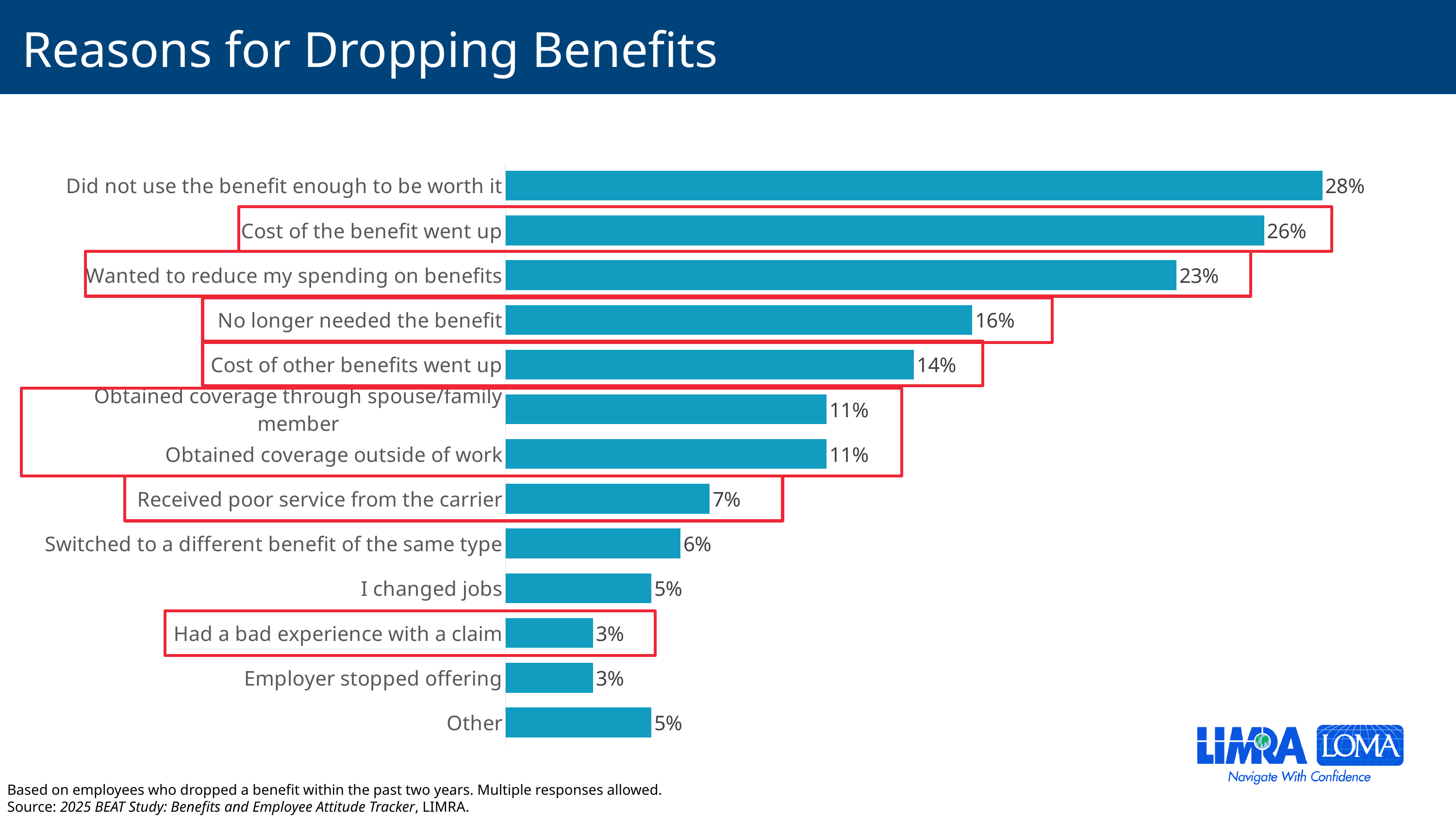
What type of chart is shown on the slide? Bar chart What percentage of employees cited "Did not use the benefit enough to be worth it" as a reason for dropping benefits? 28% What is the title of the chart on the slide? Reasons for Dropping Benefits How many reasons (categories) are listed on the chart? 13 Which is larger: "Wanted to reduce my spending on benefits" or "No longer needed the benefit"? Wanted to reduce my spending on benefits Which reason for dropping benefits has the highest percentage? Did not use the benefit enough to be worth it What is the value for "Cost of the benefit went up"? 26% What is the lowest percentage shown on the chart? 3% What is the value for "Received poor service from the carrier"? 7% What is the difference between "Did not use the benefit enough to be worth it" and "Other"? 23 percentage points What percentage is shown for "No longer needed the benefit"? 16% What is the difference between "Cost of the benefit went up" and "Cost of other benefits went up"? 12 percentage points